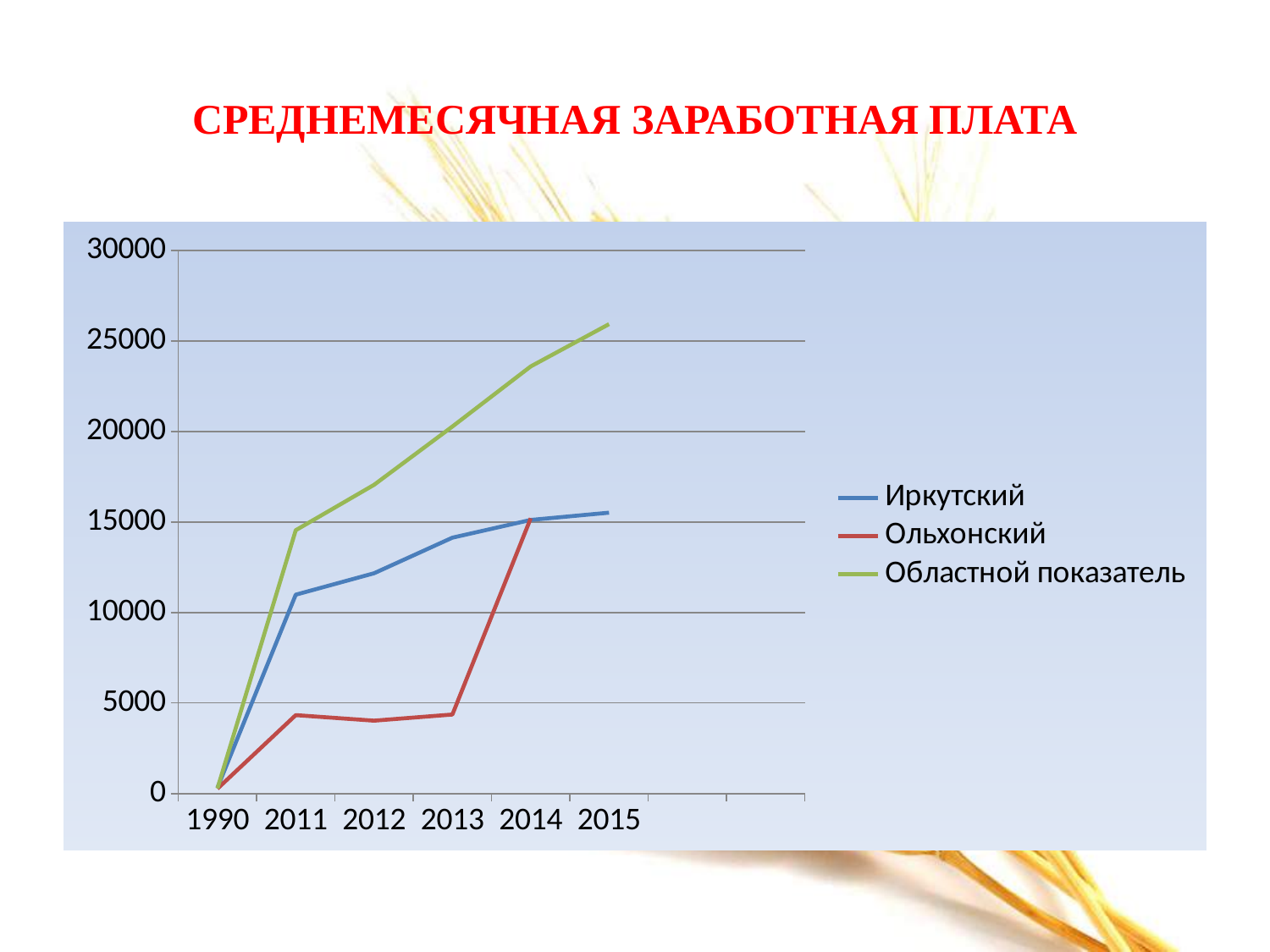
Is the value for Областной показатель in 2012 greater or less than 15000? greater How many series does the legend list? 3 Is the value for Иркутский in 2011 greater or less than 10000? greater What kind of chart is shown on the slide? line chart How many years are shown on the x axis? 6 Is the value for Областной показатель in 2015 greater or less than 25000? greater What is the title of the slide? СРЕДНЕМЕСЯЧНАЯ ЗАРАБОТНАЯ ПЛАТА Does the Областной показатель line rise or fall from 1990 to 2015? rise Which series has the lowest value in 2013? Ольхонский In 2014, which is larger: Областной показатель or Иркутский? Областной показатель Which series has the highest value in 2015? Областной показатель